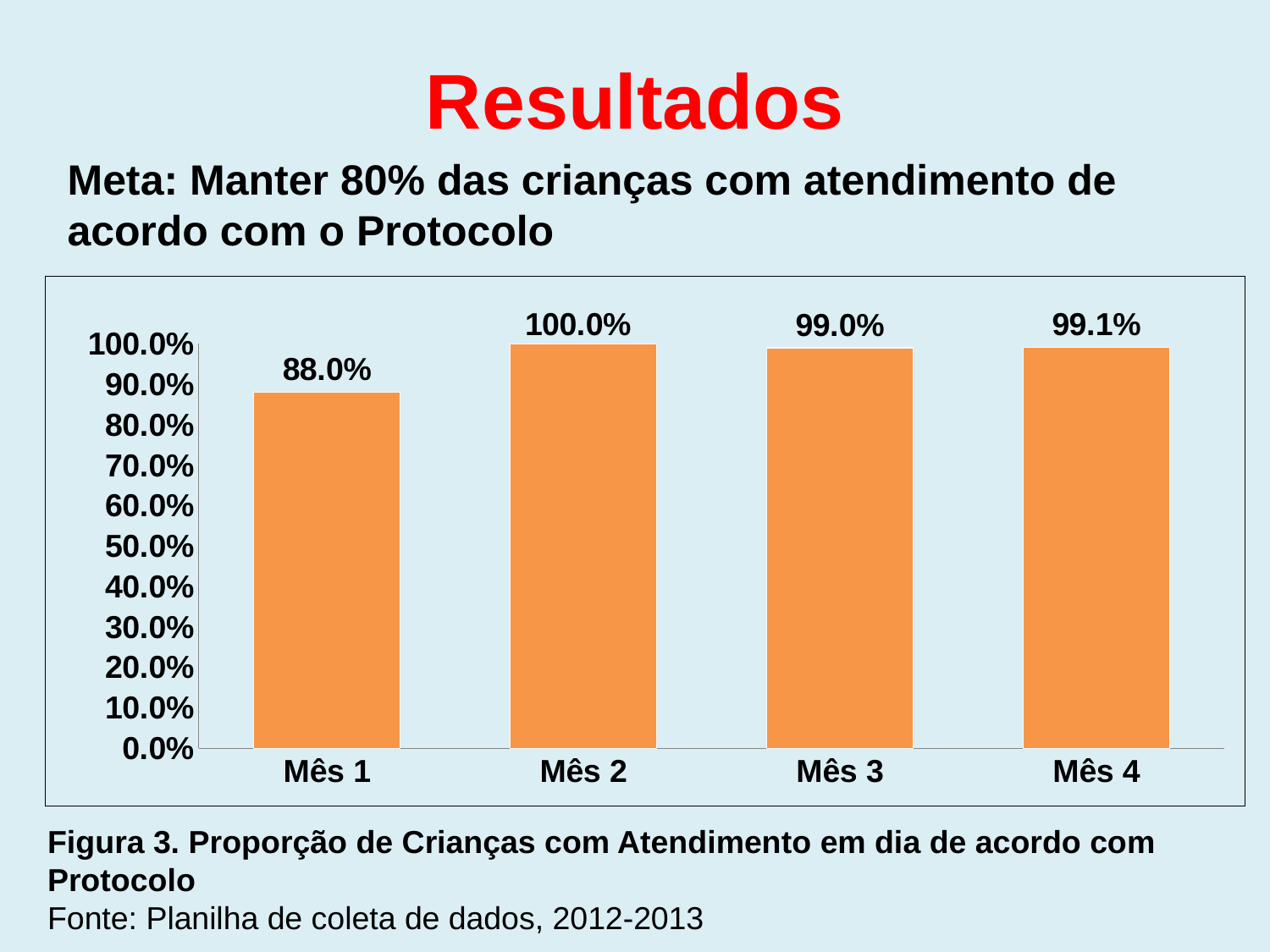
Which month has the lowest value? Mês 1 What is the difference between the values for Mês 4 and Mês 3? 0.1% Is the value for Mês 1 greater or less than 80.0%? greater What is the value for Mês 3? 99.0% Which month has the highest value? Mês 2 What is the figure caption below the chart? Figura 3. Proporção de Crianças com Atendimento em dia de acordo com Protocolo What is the difference between the values for Mês 2 and Mês 1? 12.0% How many months are shown on the x axis? 4 What kind of chart is shown on the slide? bar chart What is the value for Mês 4? 99.1% Which is larger, the value for Mês 1 or the value for Mês 3? Mês 3 What is the value for Mês 1? 88.0%